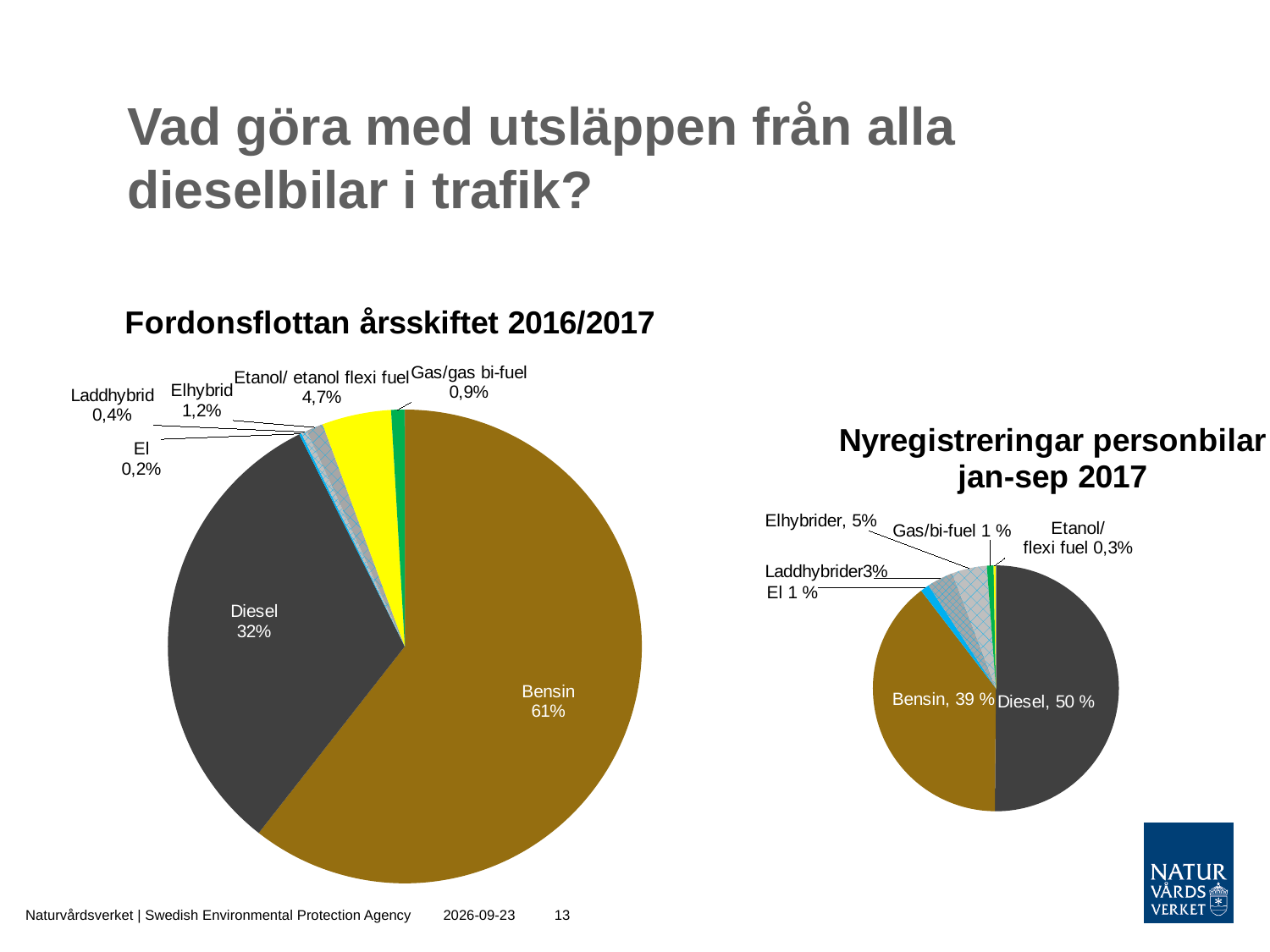
In the 'Nyregistreringar personbilar jan-sep 2017' chart, what is the value for Elhybrider? 5% In the 'Fordonsflottan årsskiftet 2016/2017' chart, what share does Diesel have? 32% In the 'Fordonsflottan årsskiftet 2016/2017' chart, what share does Bensin have? 61% In the 'Fordonsflottan årsskiftet 2016/2017' chart, what is the value for Etanol/ etanol flexi fuel? 4,7% In the 'Fordonsflottan årsskiftet 2016/2017' chart, which category has the smallest share? El In the 'Nyregistreringar personbilar jan-sep 2017' chart, which category has the largest share? Diesel In the 'Fordonsflottan årsskiftet 2016/2017' chart, how many categories are shown? 7 In the 'Nyregistreringar personbilar jan-sep 2017' chart, which is larger, Laddhybrider or Etanol/flexi fuel? Laddhybrider In the 'Nyregistreringar personbilar jan-sep 2017' chart, what share does Diesel have? 50 % In the 'Nyregistreringar personbilar jan-sep 2017' chart, what share does Bensin have? 39 % What type of chart is used for 'Nyregistreringar personbilar jan-sep 2017'? Pie chart In the 'Fordonsflottan årsskiftet 2016/2017' chart, what is the difference between the Bensin and Diesel shares? 29 percentage points